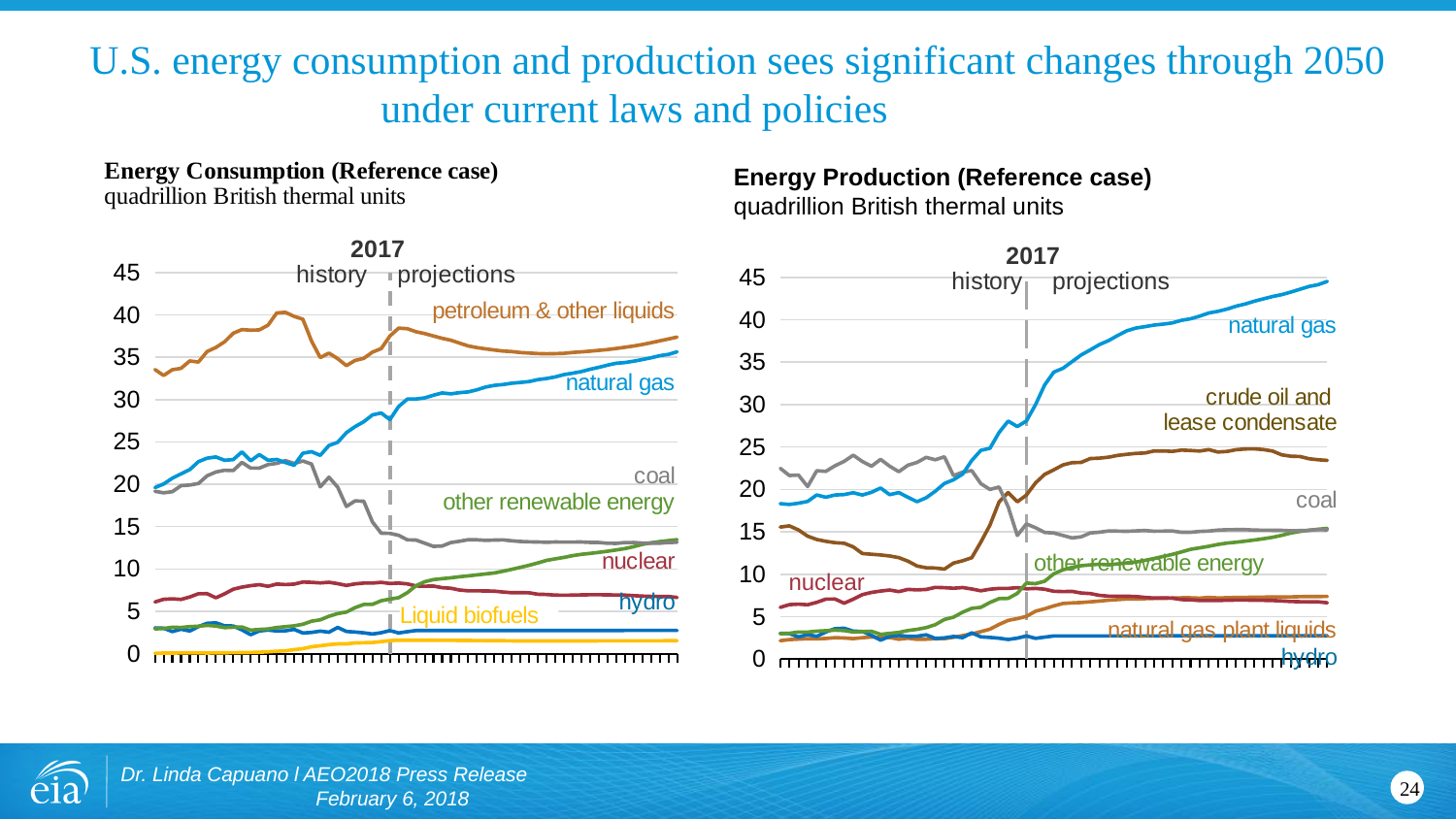
On the Energy Production (Reference case) chart, does natural gas production rise or fall over the projection period? rise How many energy sources are labelled as lines on the Energy Consumption (Reference case) chart? 7 What kind of chart is the Energy Consumption (Reference case) chart? line chart On the Energy Production (Reference case) chart, is the value for nuclear at the end of the projection period greater or less than 10? less On the Energy Consumption (Reference case) chart, at the end of the projection period, which is larger: natural gas or coal? natural gas On the Energy Production (Reference case) chart, is the value for natural gas at the end of the projection period greater or less than 40? greater On the Energy Production (Reference case) chart, which energy source has the highest value at the end of the projection period? natural gas On the Energy Consumption (Reference case) chart, is the value for coal at the end of the projection period greater or less than 15? less Which year separates history from projections on both charts? 2017 On the Energy Consumption (Reference case) chart, which energy source has the highest value at the end of the projection period? petroleum & other liquids How many energy sources are labelled as lines on the Energy Production (Reference case) chart? 7 On the Energy Consumption (Reference case) chart, which energy source has the lowest value throughout the chart? Liquid biofuels